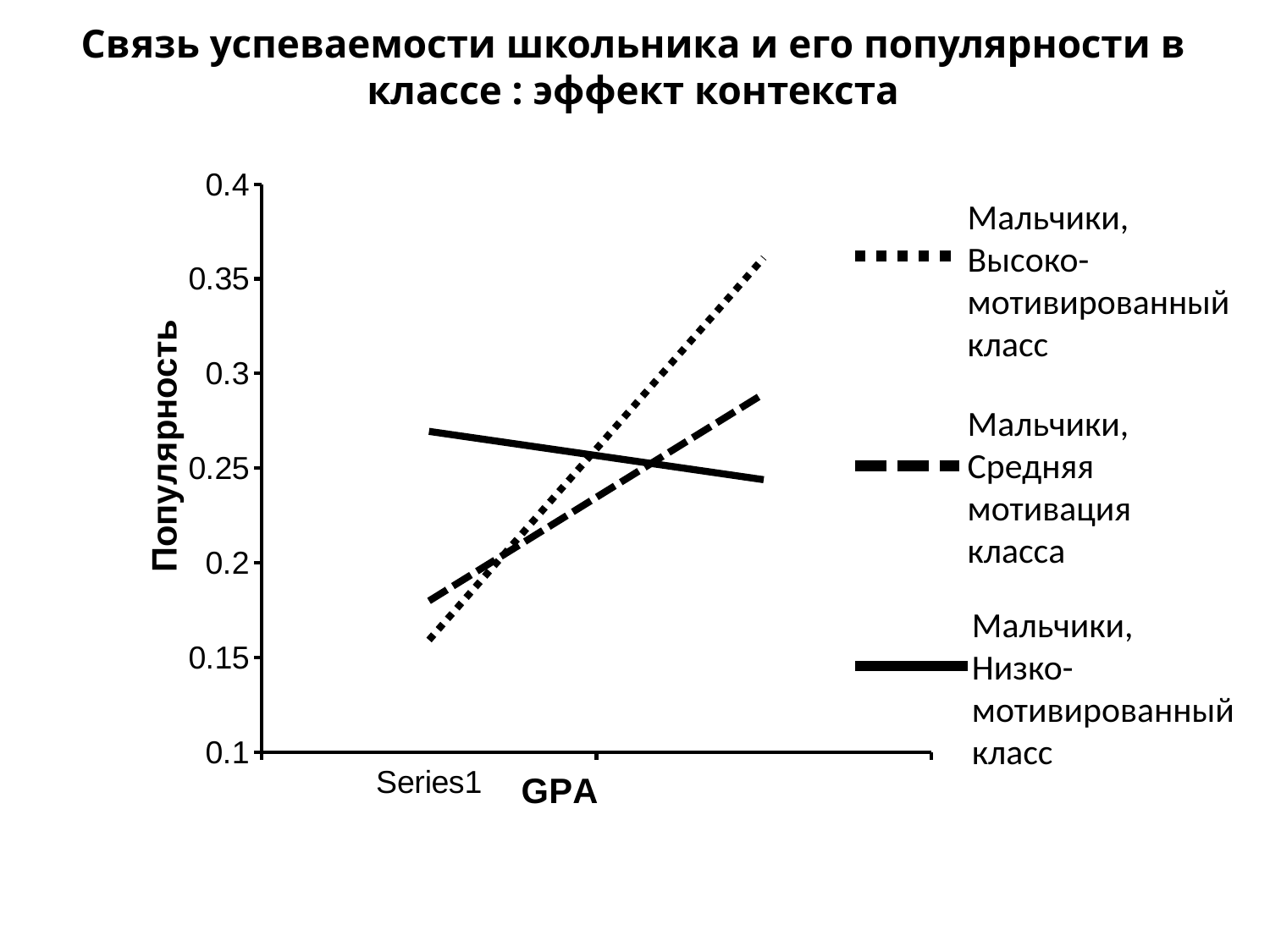
At the left end of the chart, which line is higher: 'Мальчики, Низко-мотивированный класс' or 'Мальчики, Средняя мотивация класса'? Мальчики, Низко-мотивированный класс Is the value at the left end of the 'Мальчики, Низко-мотивированный класс' line greater or less than 0.25? greater Which series reaches the highest value on the chart? Мальчики, Высоко-мотивированный класс At the right end of the chart, which line is higher: 'Мальчики, Высоко-мотивированный класс' or 'Мальчики, Низко-мотивированный класс'? Мальчики, Высоко-мотивированный класс What kind of chart is shown on the slide? line chart Does the line for 'Мальчики, Низко-мотивированный класс' rise or fall as GPA increases? falls Is the value at the left end of the 'Мальчики, Высоко-мотивированный класс' line greater or less than 0.2? less Is the value at the right end of the 'Мальчики, Высоко-мотивированный класс' line greater or less than 0.3? greater How many series does the legend list? 3 Does the line for 'Мальчики, Высоко-мотивированный класс' rise or fall as GPA increases? rises What is the title of the vertical axis? Популярность Does the line for 'Мальчики, Средняя мотивация класса' rise or fall as GPA increases? rises